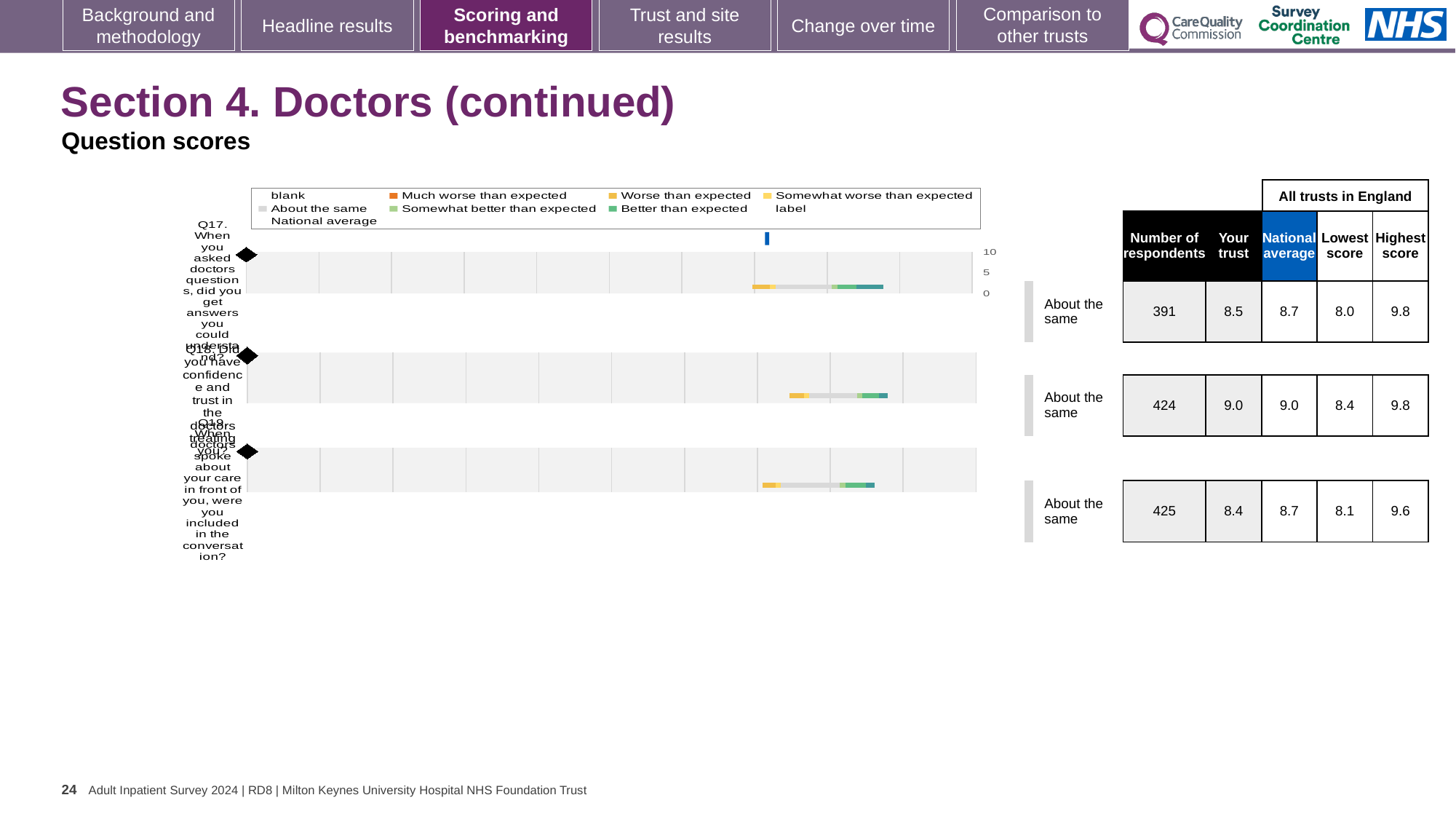
What benchmark category is shown for Q17? About the same What is the 'Your trust' score for Q17 (When you asked doctors questions, did you get answers you could understand)? 8.5 Which question has the lowest 'Your trust' score? Q19 What kind of chart is shown on the slide? bar chart What is the difference between the 'Your trust' scores for Q18 and Q17? 0.5 Which question has the highest 'Your trust' score? Q18 For Q19, which is larger: the 'Your trust' score or the national average? National average What is the national average score for Q18 (Did you have confidence and trust in the doctors treating you)? 9.0 How many questions (categories) are plotted on the chart? 3 What is the highest score among all trusts in England for Q19? 9.6 What is the lowest score among all trusts in England for Q17? 8.0 How many respondents answered Q18? 424